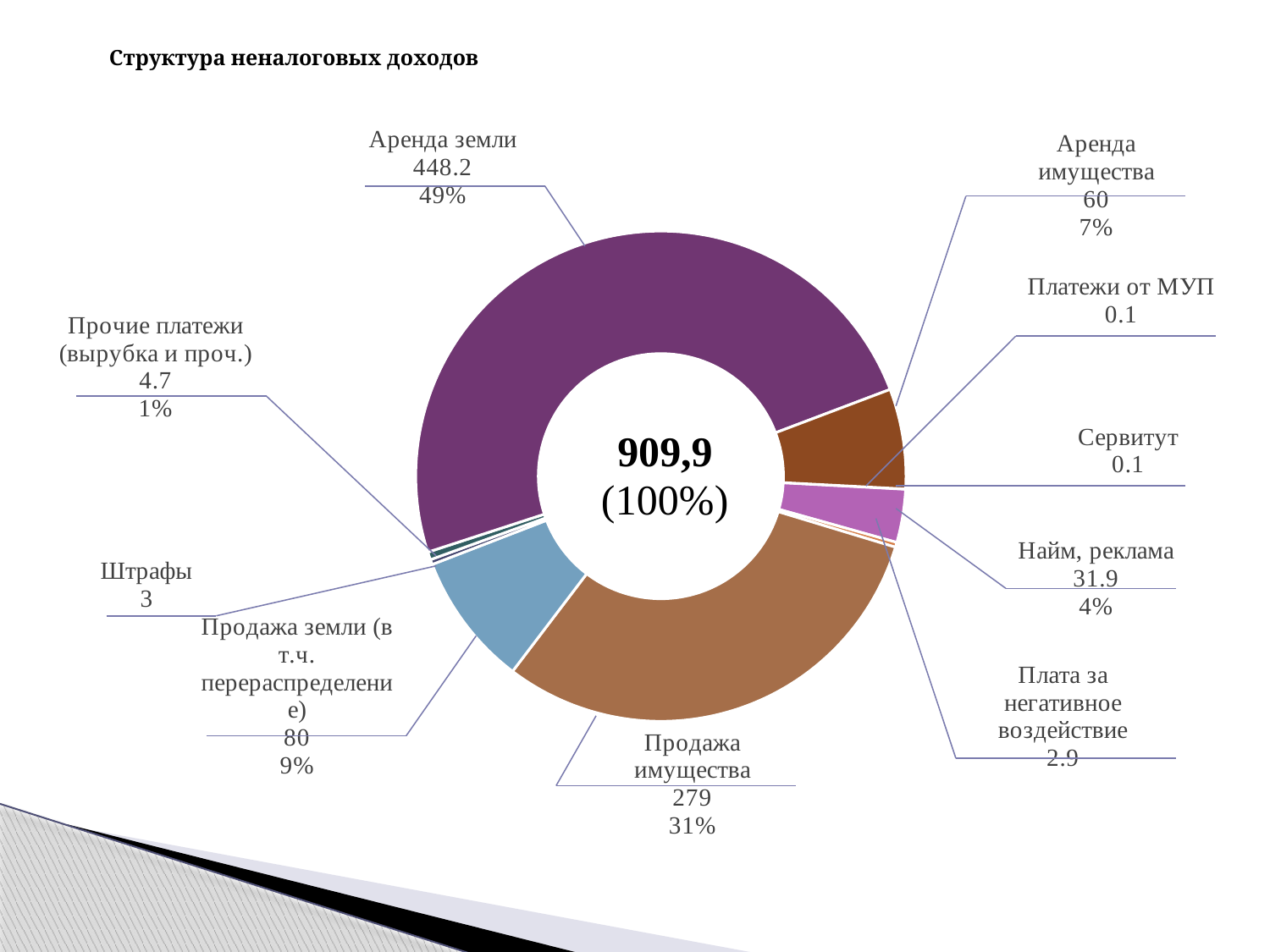
What share of the total does Аренда имущества represent? 7% Which category has the largest value? Аренда земли What kind of chart is shown on the slide? Doughnut (pie) chart What is the value for Аренда земли? 448.2 Which is larger, Аренда имущества or Продажа земли (в т.ч. перераспределение)? Продажа земли (в т.ч. перераспределение) What is the title of the chart? Структура неналоговых доходов What is the value for Плата за негативное воздействие? 2.9 What is the difference between Аренда земли and Продажа имущества? 169.2 What share of the total does Продажа имущества represent? 31% How many categories are shown in the chart? 10 What is the value for Найм, реклама? 31.9 What total value is shown in the centre of the chart? 909,9 (100%)